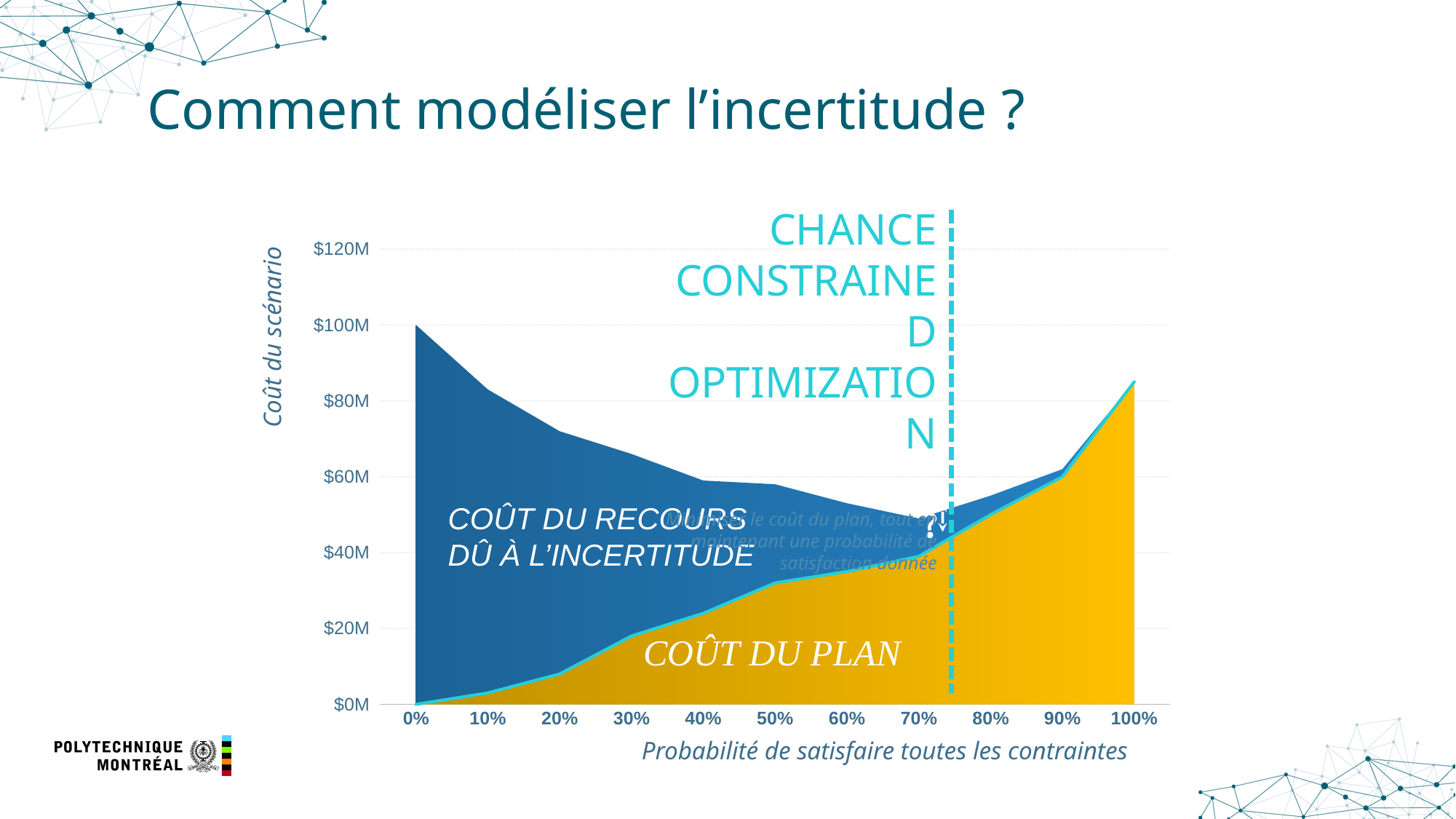
What is the total scenario cost at a probability of 0%? $100M What is the label of the x axis? Probabilité de satisfaire toutes les contraintes What kind of chart is shown on the slide? area chart Is the total scenario cost at 20% greater or less than $80M? less What is the label of the y axis? Coût du scénario How many probability tick labels are shown on the x axis? 11 What is the value of Coût du plan at a probability of 0%? $0M Is the value of Coût du plan at 50% greater or less than $20M? greater Does Coût du plan rise or fall as the probability increases from 0% to 100%? rise Is the total scenario cost at 100% greater or less than $80M? greater At a probability of 0%, which is larger: Coût du recours dû à l'incertitude or Coût du plan? Coût du recours dû à l'incertitude